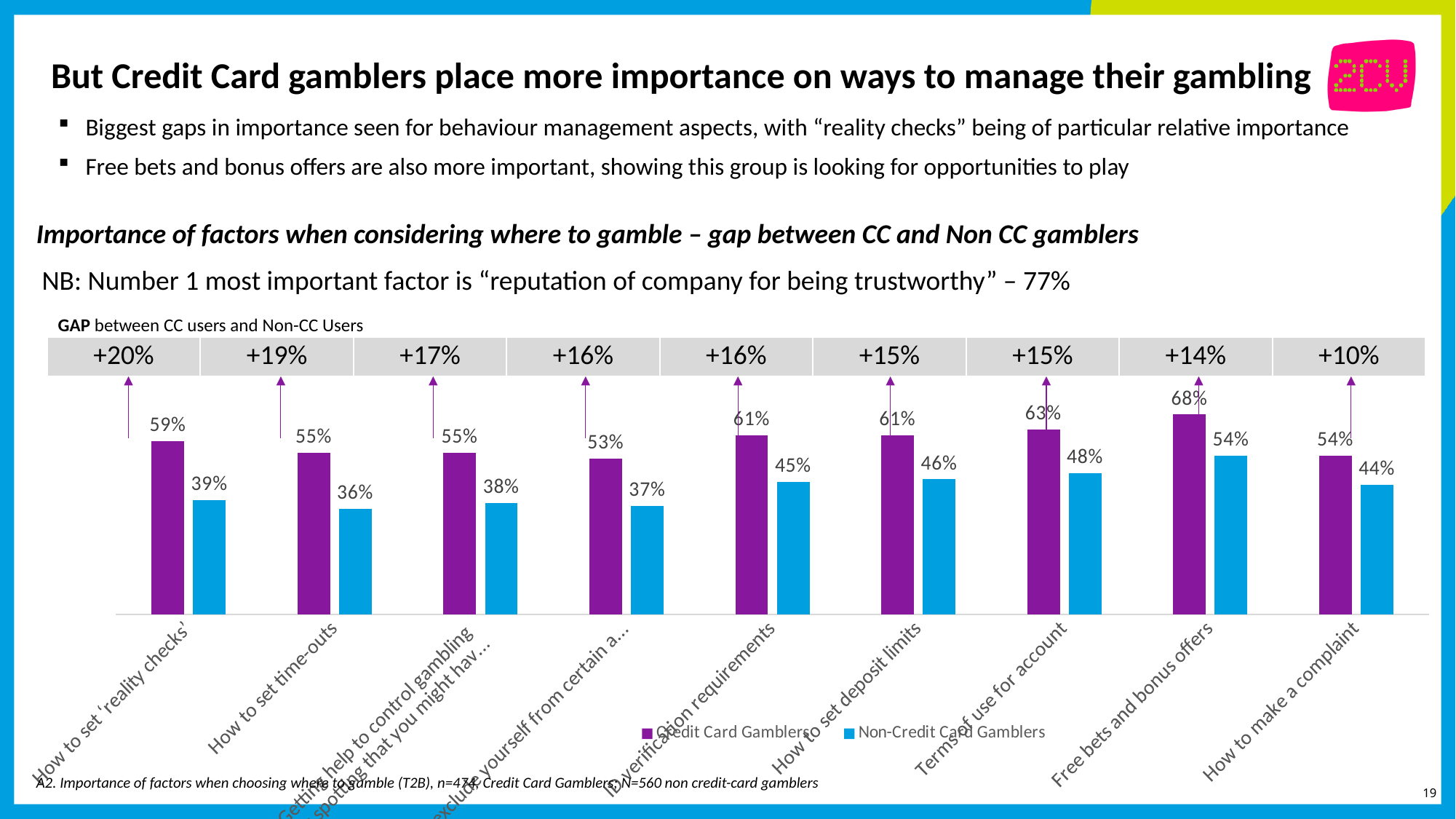
Which category has the lowest value for Non-Credit Card Gamblers? How to set time-outs What is the value for Credit Card Gamblers for 'How to set reality checks'? 59% How many series does the chart legend list? 2 Which category has the highest value for Credit Card Gamblers? Free bets and bonus offers What is the difference between the Credit Card Gamblers and Non-Credit Card Gamblers values for 'Terms of use for account'? 15% What gap between CC users and Non-CC users is shown above 'How to set reality checks'? +20% What is the value for Credit Card Gamblers for 'Free bets and bonus offers'? 68% What kind of chart is shown on the slide? bar chart What is the value for Non-Credit Card Gamblers for 'How to make a complaint'? 44% What is the value for Non-Credit Card Gamblers for 'How to set time-outs'? 36% Which is larger for 'How to set deposit limits': the Credit Card Gamblers value or the Non-Credit Card Gamblers value? Credit Card Gamblers How many categories are shown on the x axis of the chart? 9